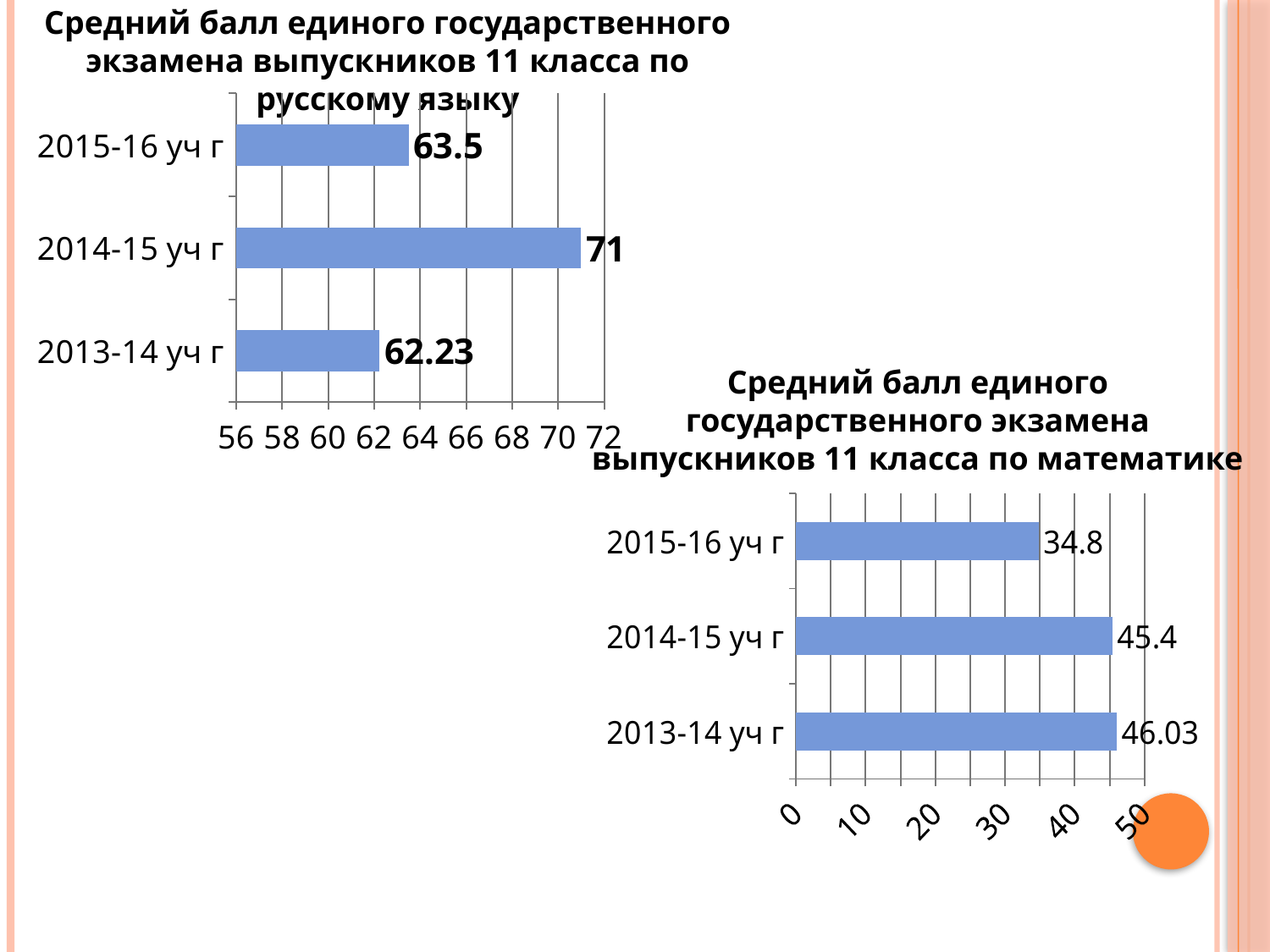
In the Russian language chart (top left), which is larger: the score for 2015-16 уч г or 2013-14 уч г? 2015-16 уч г In the mathematics chart (bottom right), is the value for 2015-16 уч г greater or less than 40? less In the Russian language chart (top left), which school year has the highest average score? 2014-15 уч г In the mathematics chart (bottom right), which school year has the lowest average score? 2015-16 уч г In the mathematics chart (bottom right), what is the difference between the scores for 2014-15 уч г and 2015-16 уч г? 10.6 In the mathematics chart (bottom right), what is the average score for 2013-14 уч г? 46.03 How many school years are shown in the mathematics chart (bottom right)? 3 What type of chart is used for the Russian language scores (top left)? Bar chart In the Russian language chart (top left), what is the difference between the scores for 2014-15 уч г and 2015-16 уч г? 7.5 In the Russian language chart (top left), what is the average score for 2014-15 уч г? 71 In the Russian language chart (top left), what is the average score for 2013-14 уч г? 62.23 In the mathematics chart (bottom right), what is the average score for 2015-16 уч г? 34.8